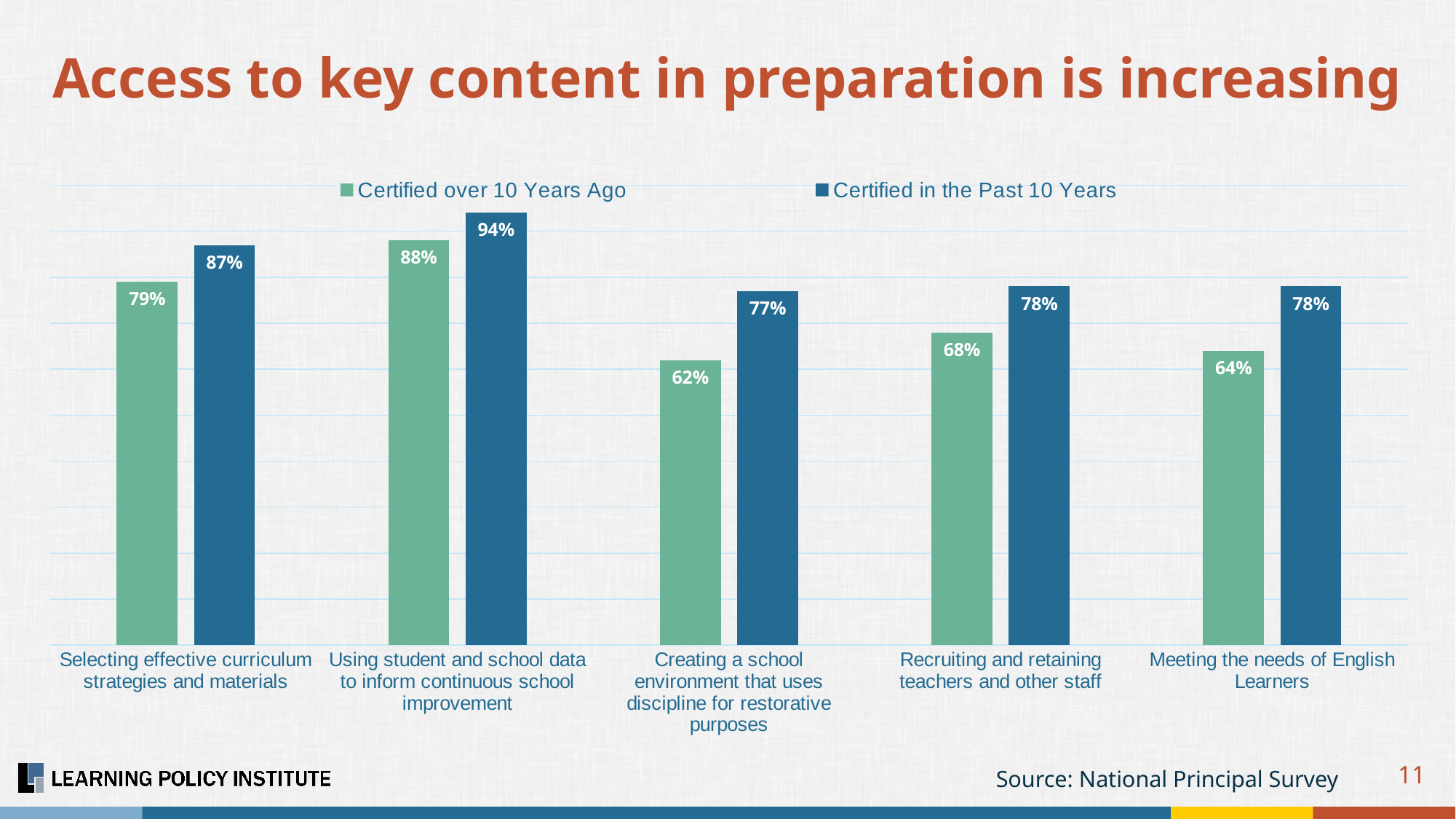
What is the value for "Certified over 10 Years Ago" for "Creating a school environment that uses discipline for restorative purposes"? 62% Which is larger: the "Certified over 10 Years Ago" value for "Selecting effective curriculum strategies and materials" or for "Recruiting and retaining teachers and other staff"? Selecting effective curriculum strategies and materials What is the difference between the "Certified in the Past 10 Years" and "Certified over 10 Years Ago" values for "Creating a school environment that uses discipline for restorative purposes"? 15% What is the difference between the "Certified in the Past 10 Years" and "Certified over 10 Years Ago" values for "Meeting the needs of English Learners"? 14% What is the value for "Certified in the Past 10 Years" for "Using student and school data to inform continuous school improvement"? 94% How many series does the legend list? 2 What is the title of the slide? Access to key content in preparation is increasing What kind of chart is shown on the slide? Bar chart Which category has the highest value for "Certified in the Past 10 Years"? Using student and school data to inform continuous school improvement What is the value for "Certified over 10 Years Ago" for "Meeting the needs of English Learners"? 64% Which category has the lowest value for "Certified over 10 Years Ago"? Creating a school environment that uses discipline for restorative purposes How many categories are shown on the x axis? 5